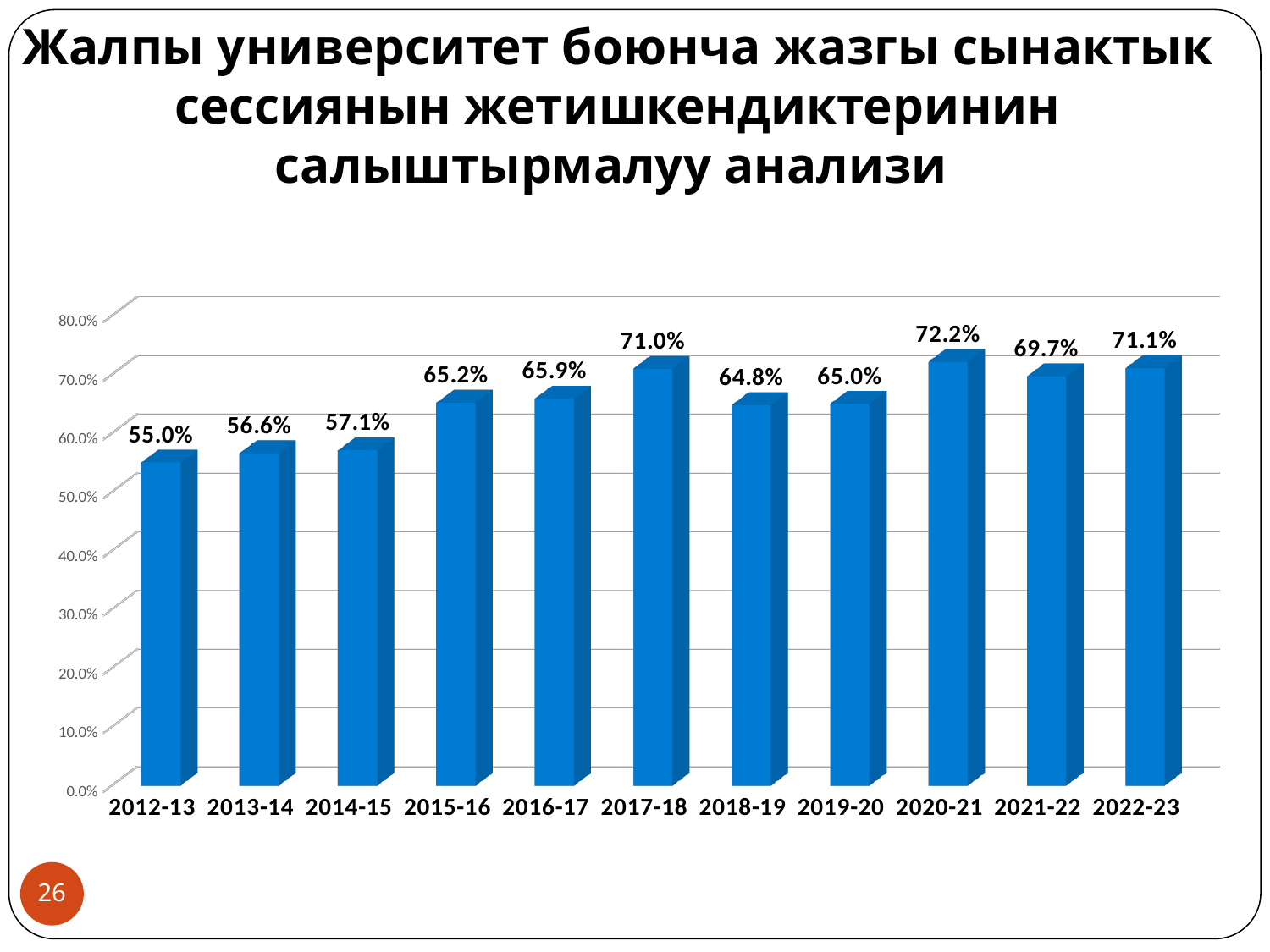
What is the difference between the values for 2020-21 and 2012-13? 17.2% What kind of chart is shown on the slide? bar chart What is the value for 2017-18? 71.0% What is the difference between the values for 2021-22 and 2022-23? 1.4% How many academic years are shown on the x axis? 11 Do the values generally rise or fall from 2012-13 to 2022-23? rise What is the value for 2022-23? 71.1% Which is larger, the value for 2015-16 or the value for 2018-19? 2015-16 Is the value for 2014-15 greater or less than 60.0%? less Which academic year has the highest value? 2020-21 Which academic year has the lowest value? 2012-13 What is the value for 2012-13? 55.0%